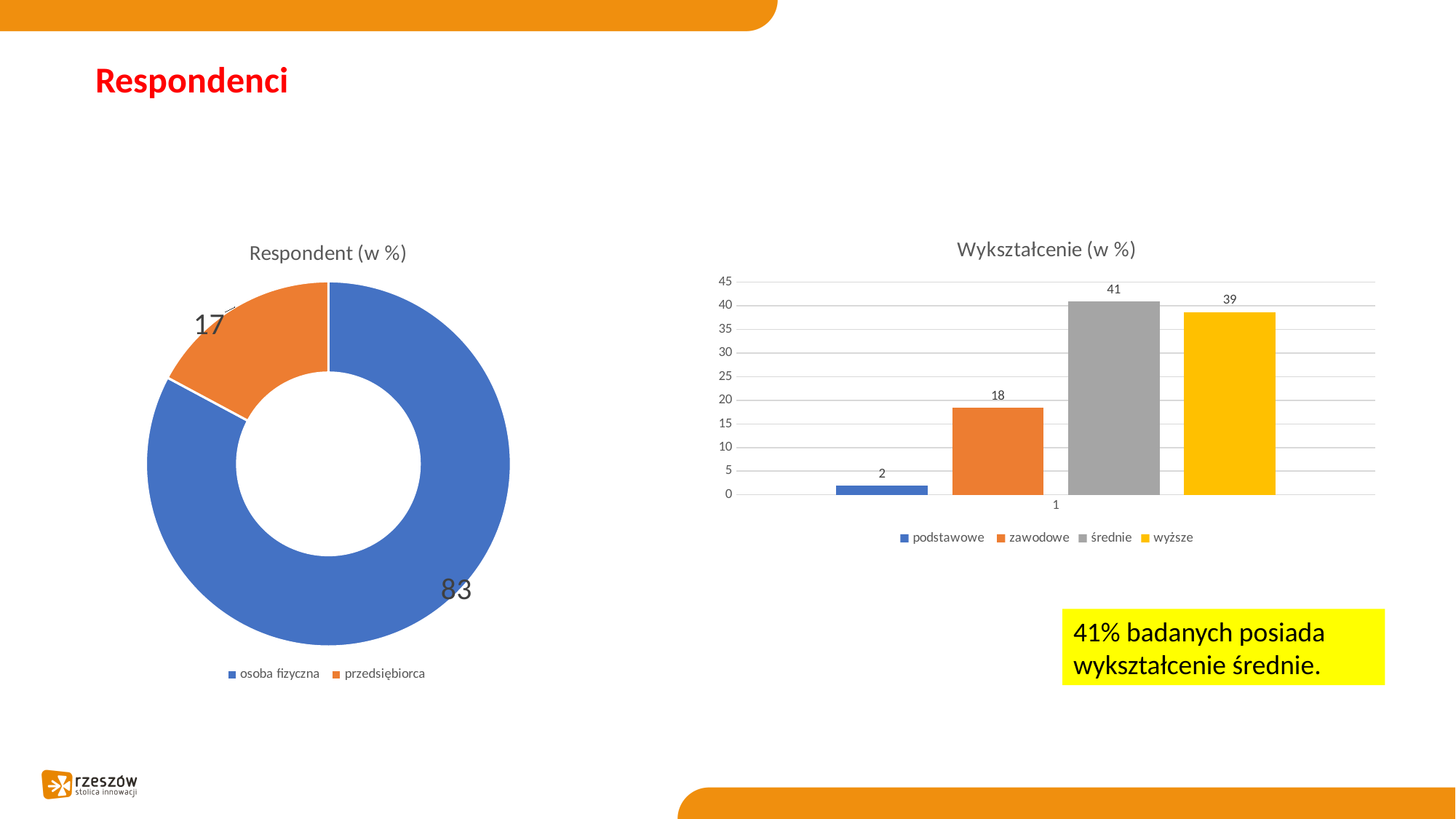
In the 'Wykształcenie (w %)' chart, which category has the lowest value? podstawowe How many series does the legend of the 'Wykształcenie (w %)' chart list? 4 What kind of chart is the 'Respondent (w %)' chart? Doughnut chart In the 'Respondent (w %)' chart, which category has the larger share? osoba fizyczna In the 'Wykształcenie (w %)' chart, which category has the highest value? średnie What kind of chart is the 'Wykształcenie (w %)' chart? Bar chart In the 'Respondent (w %)' chart, what is the difference between osoba fizyczna and przedsiębiorca? 66 In the 'Wykształcenie (w %)' chart, what is the difference between zawodowe and wyższe? 21 In the 'Wykształcenie (w %)' chart, what is the value for podstawowe? 2 In the 'Wykształcenie (w %)' chart, what is the value for średnie? 41 In the 'Respondent (w %)' chart, what is the value for przedsiębiorca? 17 In the 'Respondent (w %)' chart, what is the value for osoba fizyczna? 83